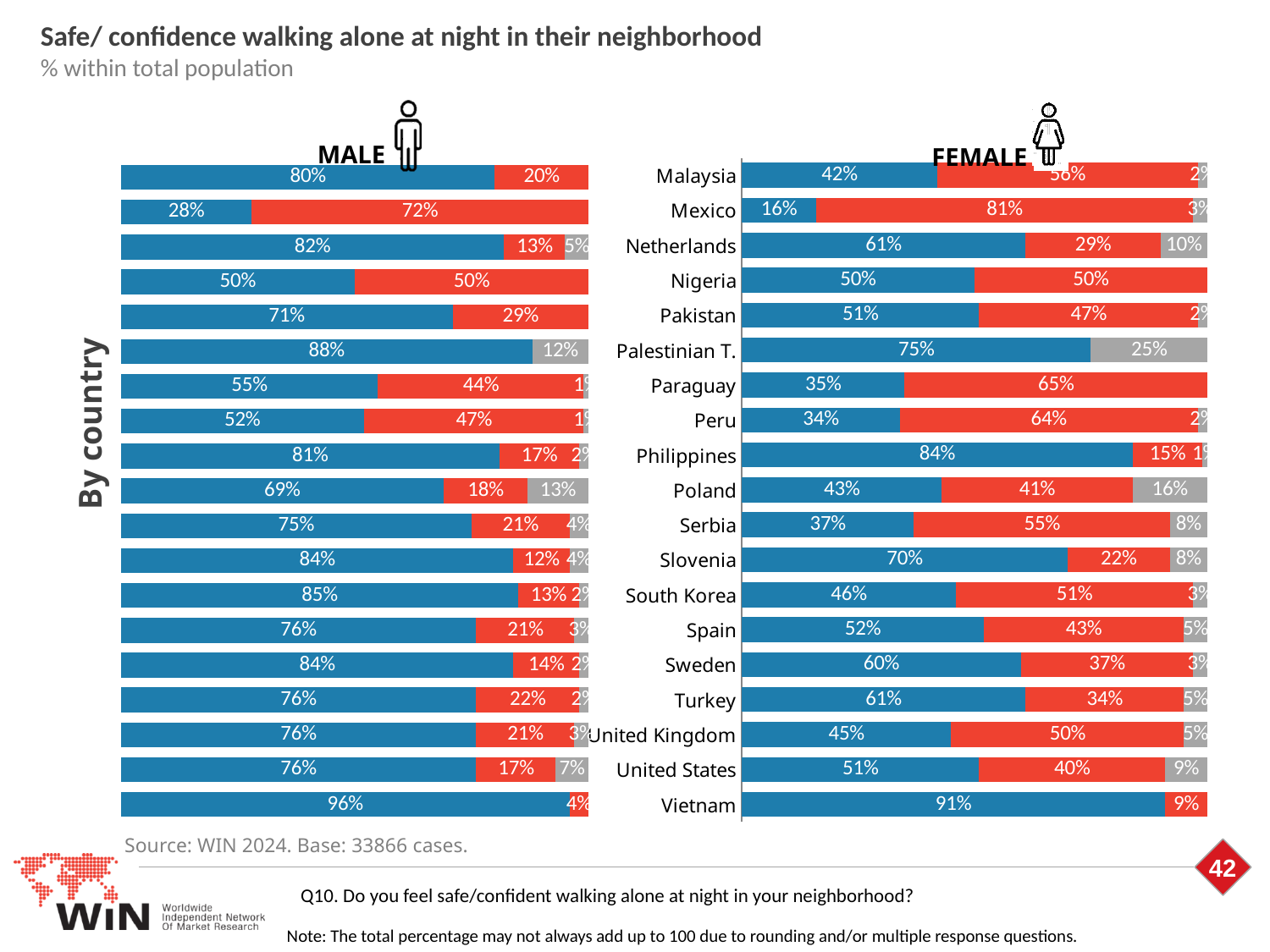
In the MALE chart, what is the value of the blue segment for Vietnam? 96% In the FEMALE chart, which is larger: the blue segment for Slovenia or the blue segment for Poland? Slovenia What type of chart is used to show the MALE and FEMALE data? Bar chart In the FEMALE chart, which country has the smallest blue segment? Mexico Which chart is positioned on the left side of the slide, MALE or FEMALE? MALE In the FEMALE chart, what is the value of the blue segment for Mexico? 16% In the MALE chart for Mexico, how much larger is the red segment (72%) than the blue segment (28%)? 44 percentage points How many countries are listed in the charts? 19 What is the difference between the blue segment for Vietnam in the MALE chart (96%) and in the FEMALE chart (91%)? 5 percentage points In the MALE chart, what is the value of the grey segment for Poland? 13% In the FEMALE chart, what is the value of the red segment for Paraguay? 65% In the MALE chart, which country has the largest blue segment? Vietnam